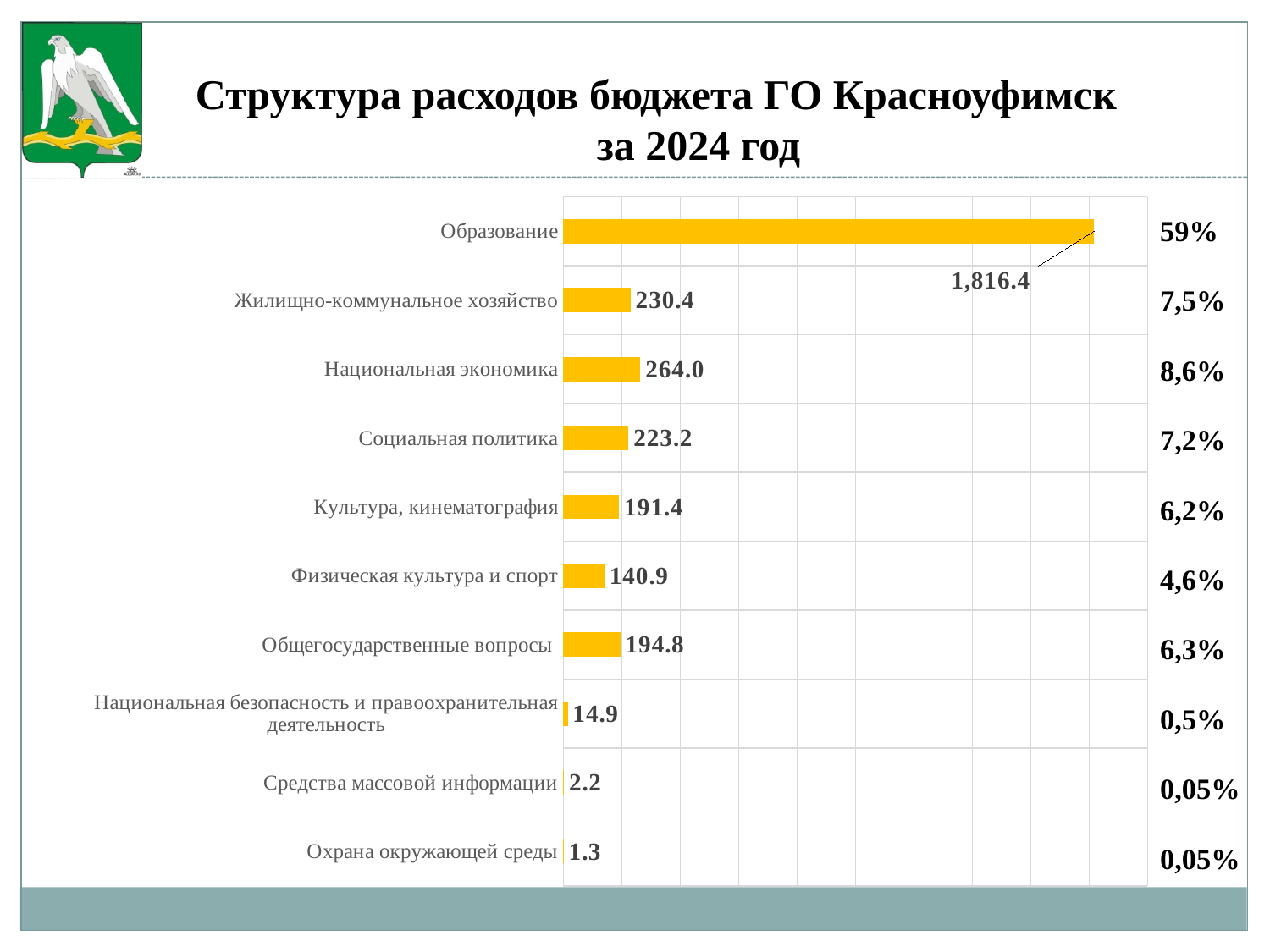
What is the difference between the values for Национальная экономика and Жилищно-коммунальное хозяйство? 33.6 Which is larger, the value for Общегосударственные вопросы or the value for Культура, кинематография? Общегосударственные вопросы What is the value for Национальная экономика? 264.0 What percentage is shown next to Образование? 59% Which category has the lowest value? Охрана окружающей среды How many categories are shown in the chart? 10 What is the title of the slide? Структура расходов бюджета ГО Красноуфимск за 2024 год What kind of chart is shown on the slide? Bar chart What is the value for Физическая культура и спорт? 140.9 Which category has the highest value? Образование What is the value for Охрана окружающей среды? 1.3 What is the value for Образование? 1,816.4